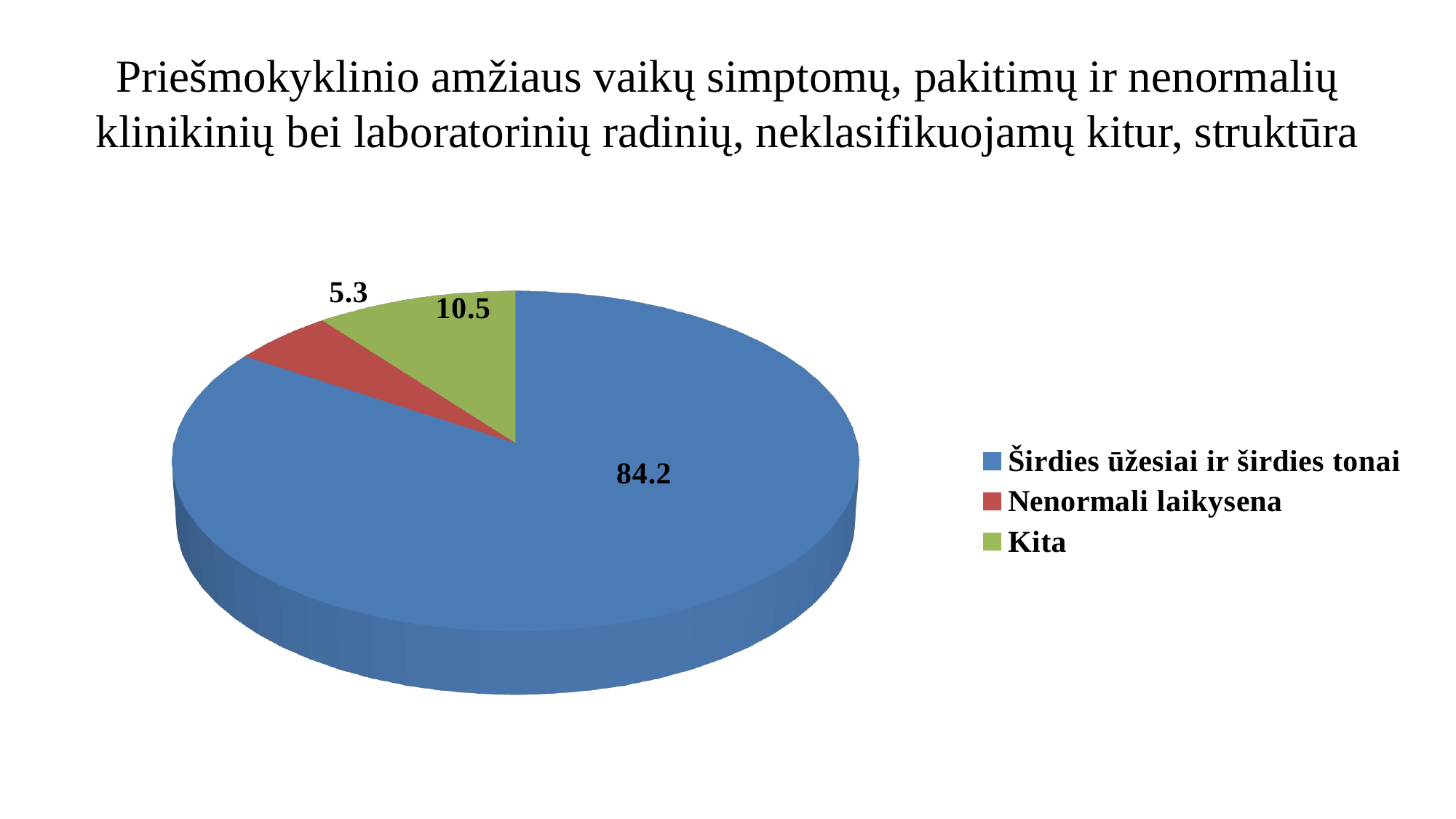
What is the value for Kita? 10.5 Which is larger, the value for Kita or the value for Nenormali laikysena? Kita What is the difference between the values for Širdies ūžesiai ir širdies tonai and Kita? 73.7 What is the difference between the values for Kita and Nenormali laikysena? 5.2 What is the value for Nenormali laikysena? 5.3 How many categories does the pie chart have? 3 Which category has the smallest slice? Nenormali laikysena What is the value for Širdies ūžesiai ir širdies tonai? 84.2 What kind of chart is shown on the slide? Pie chart What colour is the slice for Kita? Green Which category has the largest slice? Širdies ūžesiai ir širdies tonai Which category is shown in red in the legend? Nenormali laikysena